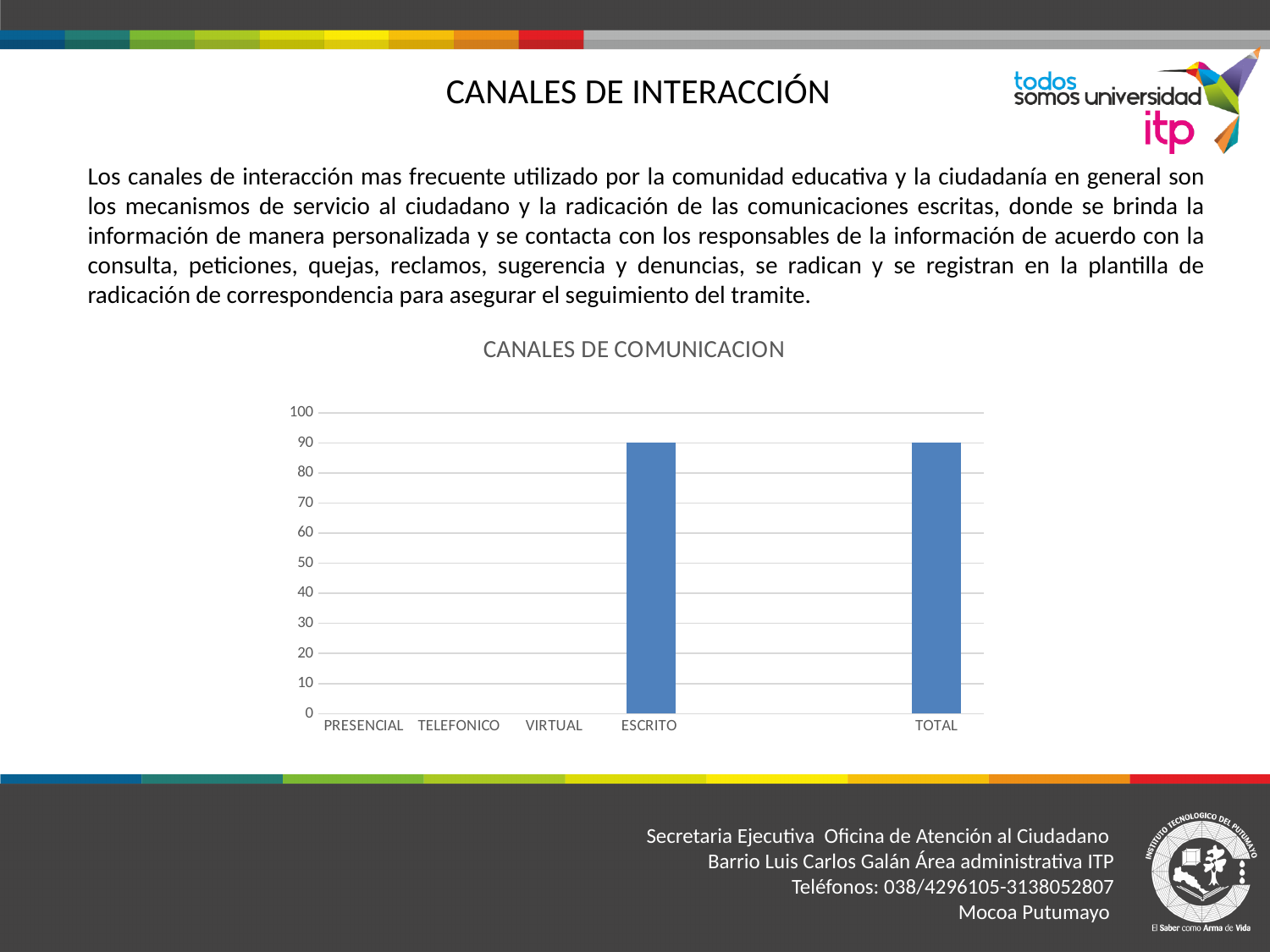
Is the value for TOTAL greater or less than 80? greater Which is larger, the value for ESCRITO or the value for PRESENCIAL? ESCRITO What kind of chart is shown on the slide? Bar chart Which is larger, the value for TOTAL or the value for VIRTUAL? TOTAL Is the value for ESCRITO greater or less than 50? greater What is the highest value shown on the vertical axis of the chart? 100 What is the value for ESCRITO in the CANALES DE COMUNICACION chart? 90 What is the title of the chart on the slide? CANALES DE COMUNICACION What is the value for TOTAL in the CANALES DE COMUNICACION chart? 90 What is the difference between the values for ESCRITO and TOTAL? 0 How many bars are visible in the CANALES DE COMUNICACION chart? 2